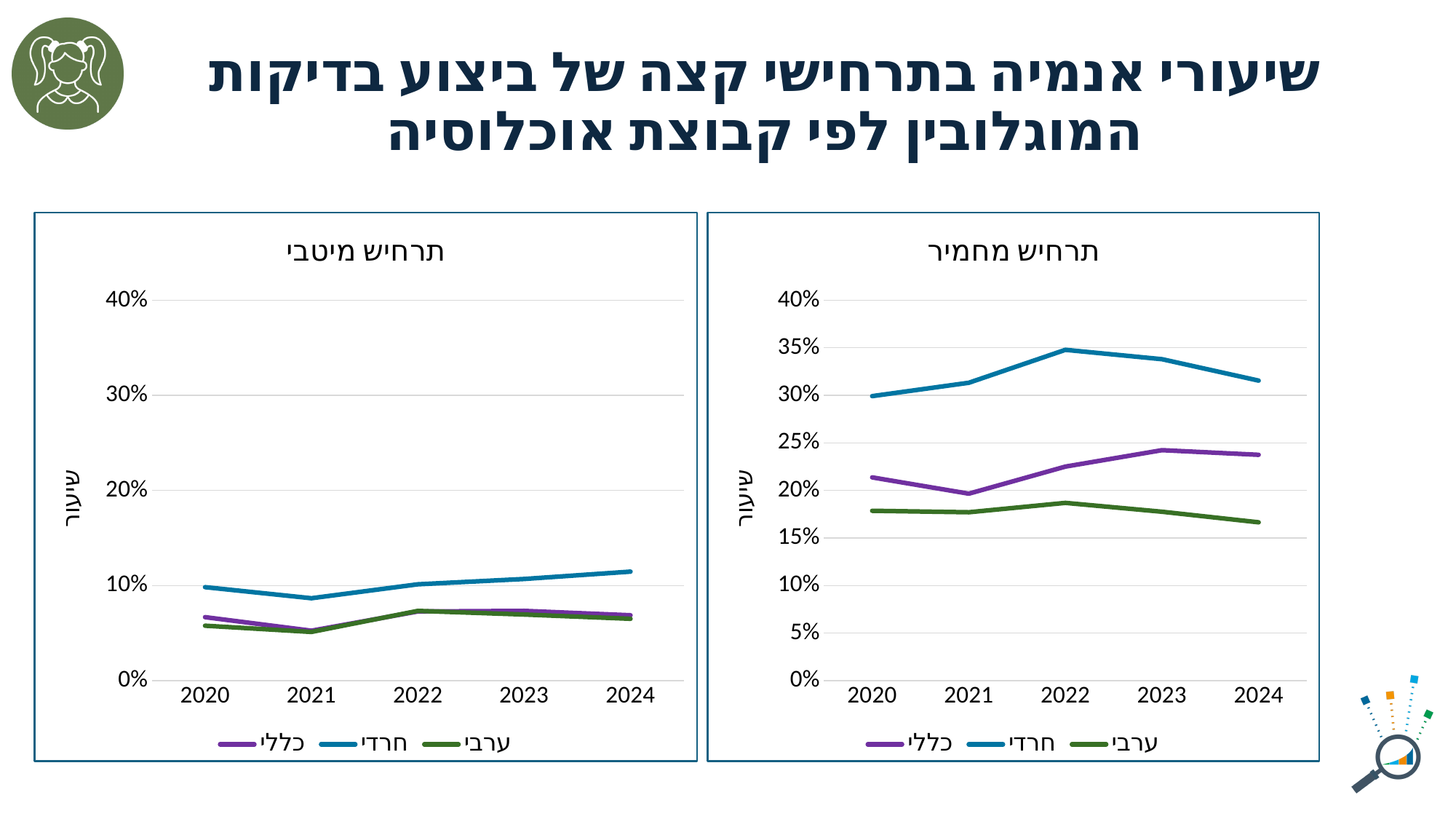
How many years are shown on the x axis of the left chart (תרחיש מיטבי)? 5 In the right chart (תרחיש מחמיר), which series has the highest value in 2022? חרדי What kind of chart is the left chart titled תרחיש מיטבי? line chart How many series does the legend of the right chart (תרחיש מחמיר) list? 3 In the right chart (תרחיש מחמיר), which series has the lowest value in 2024? ערבי In the right chart (תרחיש מחמיר), in which year does the חרדי series reach its highest value? 2022 In the left chart (תרחיש מיטבי), is the value for חרדי in 2024 greater or less than 10%? greater In the right chart (תרחיש מחמיר), does the חרדי line rise or fall from 2022 to 2024? fall In the right chart (תרחיש מחמיר), is the value for ערבי in 2024 greater or less than 20%? less In the right chart (תרחיש מחמיר), which is larger in 2021: כללי or ערבי? כללי In the left chart (תרחיש מיטבי), is the value for כללי in 2021 greater or less than 10%? less